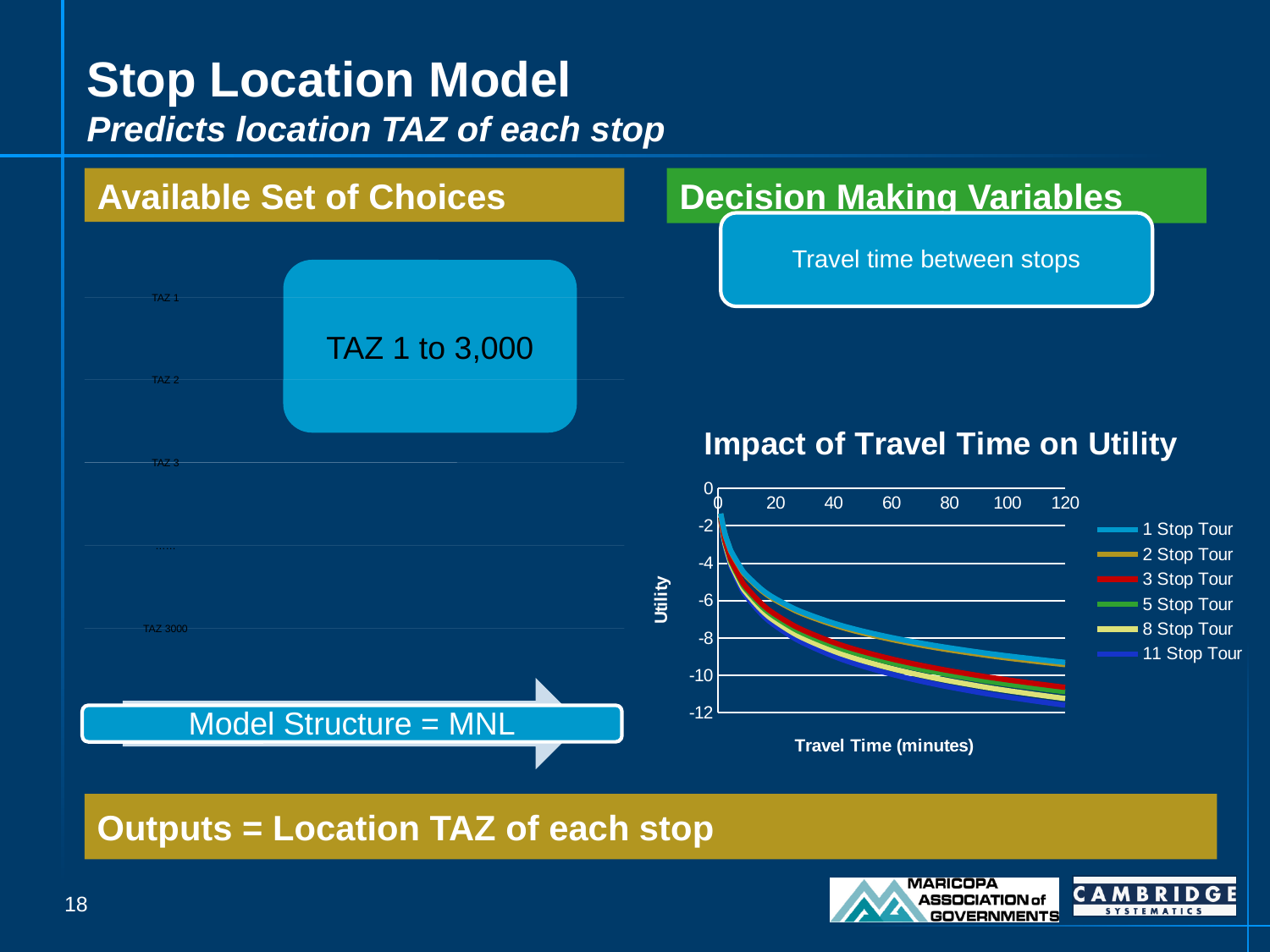
In the 'Impact of Travel Time on Utility' chart, at 120 minutes is the utility for the 1 Stop Tour greater or less than -10? greater What kind of chart is 'Impact of Travel Time on Utility'? line chart In the 'Impact of Travel Time on Utility' chart, at 120 minutes which has the higher utility, the 1 Stop Tour or the 11 Stop Tour? 1 Stop Tour What is the x-axis label of the 'Impact of Travel Time on Utility' chart? Travel Time (minutes) In the 'Impact of Travel Time on Utility' chart, at 20 minutes is the utility for the 1 Stop Tour greater or less than -8? greater In the 'Impact of Travel Time on Utility' chart, do the utility values rise or fall as travel time increases? fall In the 'Impact of Travel Time on Utility' chart, which series has the lowest utility at 120 minutes? 11 Stop Tour What is the title of the chart on the slide? Impact of Travel Time on Utility How many series does the legend of the 'Impact of Travel Time on Utility' chart list? 6 In the 'Impact of Travel Time on Utility' chart, at 120 minutes is the utility for the 11 Stop Tour greater or less than -10? less